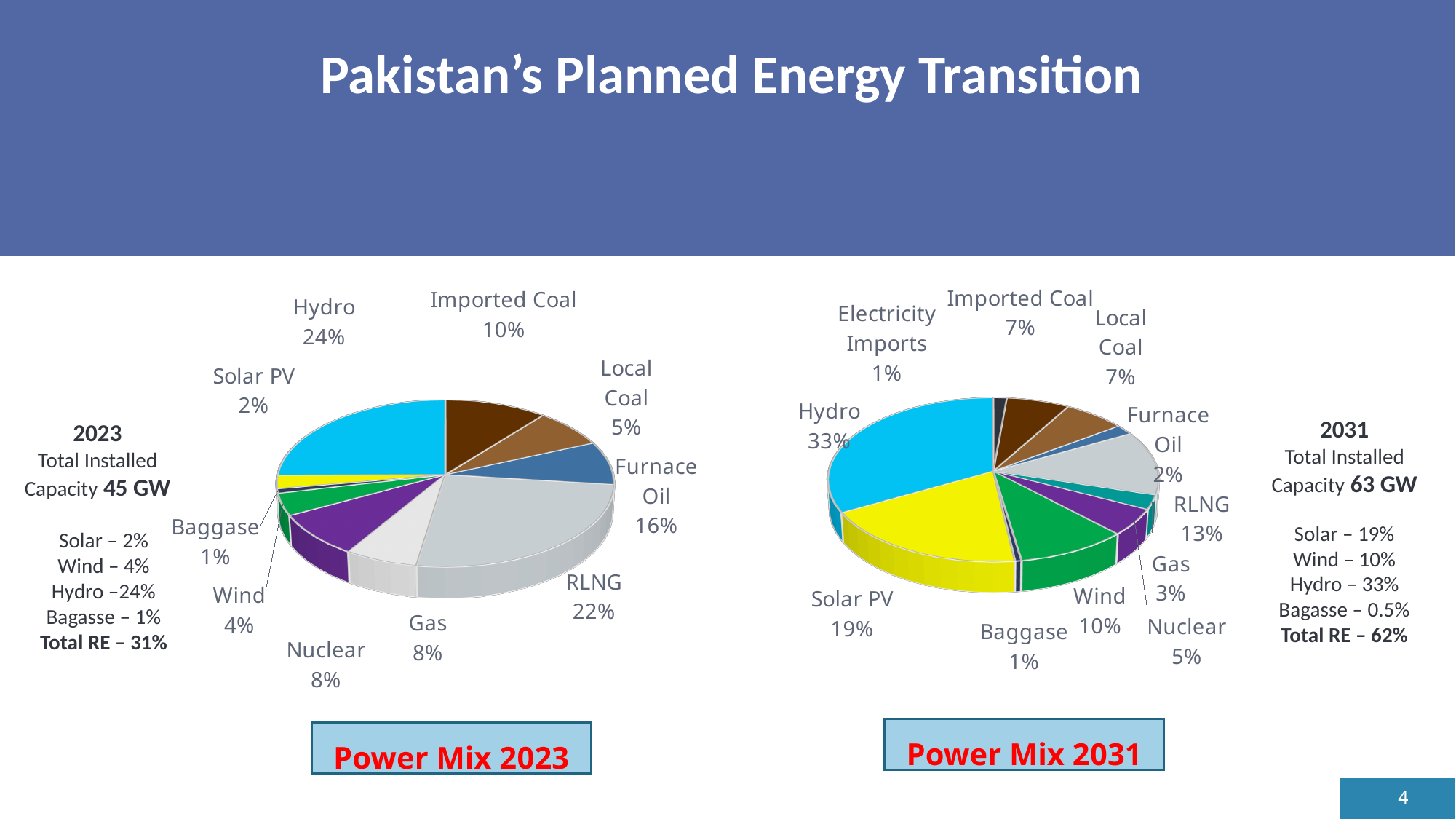
In the Power Mix 2031 chart, what share does Electricity Imports have? 1% In the Power Mix 2031 chart, which source has the largest share? Hydro In the Power Mix 2023 chart, what share does Hydro have? 24% In the Power Mix 2031 chart, what share does RLNG have? 13% In the Power Mix 2031 chart, what share does Solar PV have? 19% In the Power Mix 2023 chart, what is the difference between the Furnace Oil share and the Imported Coal share? 6% How many sources are shown in the Power Mix 2031 chart? 11 How many sources are shown in the Power Mix 2023 chart? 10 In the Power Mix 2023 chart, what share does RLNG have? 22% What type of chart is the Power Mix 2023 chart? Pie chart In the Power Mix 2023 chart, which source has the smallest share? Baggase In the Power Mix 2031 chart, which is larger, the Wind share or the Nuclear share? Wind